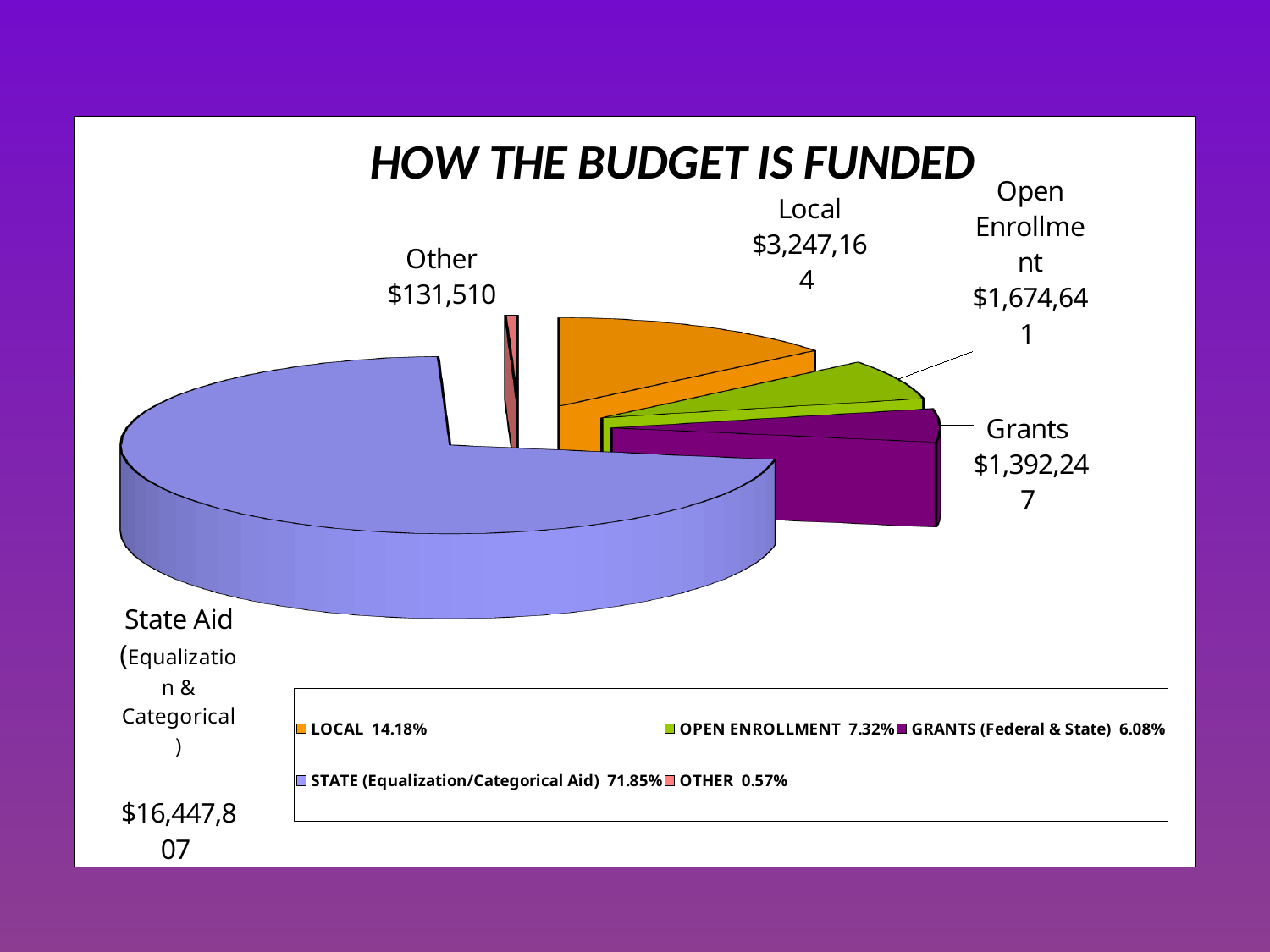
What is the difference between the Local value and the Open Enrollment value? $1,572,523 What is the value shown for Grants? $1,392,247 What is the value shown for Other? $131,510 Which funding source has the smallest slice of the pie? Other Which is larger, Open Enrollment or Grants? Open Enrollment According to the legend, what share of the budget comes from Open Enrollment? 7.32% Which funding source has the largest slice of the pie? State Aid (Equalization & Categorical) What is the value shown for Local? $3,247,164 What kind of chart is shown on the slide? Pie chart How many slices does the pie chart have? 5 What is the title of the chart? HOW THE BUDGET IS FUNDED What is the value shown for State Aid (Equalization & Categorical)? $16,447,807